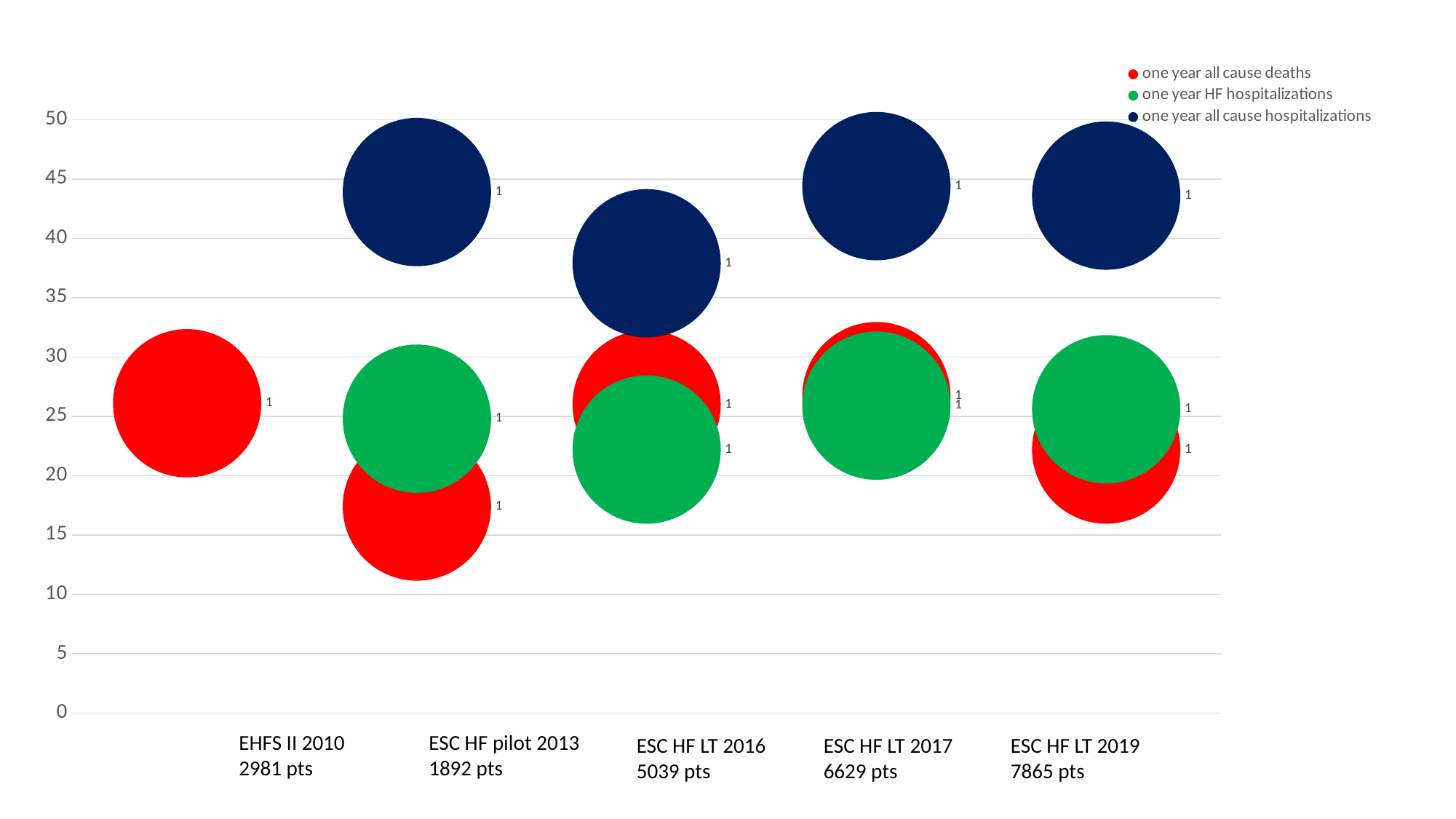
What kind of chart is shown on the slide? bubble chart Is the value for one year all cause deaths in EHFS II 2010 greater or less than 20? greater Is the value for one year all cause hospitalizations in ESC HF LT 2016 greater or less than 45? less Is the value for one year all cause hospitalizations in ESC HF pilot 2013 greater or less than 40? greater Which is larger: one year all cause hospitalizations in ESC HF LT 2016 or in ESC HF LT 2017? ESC HF LT 2017 How many series does the legend list? 3 What colour represents one year HF hospitalizations in the legend? green How many registries (categories) are shown along the x axis? 5 Which registry has the lowest value for one year all cause hospitalizations? ESC HF LT 2016 Which registry has the lowest value for one year all cause deaths? ESC HF pilot 2013 Which is larger: one year all cause deaths in EHFS II 2010 or in ESC HF pilot 2013? EHFS II 2010